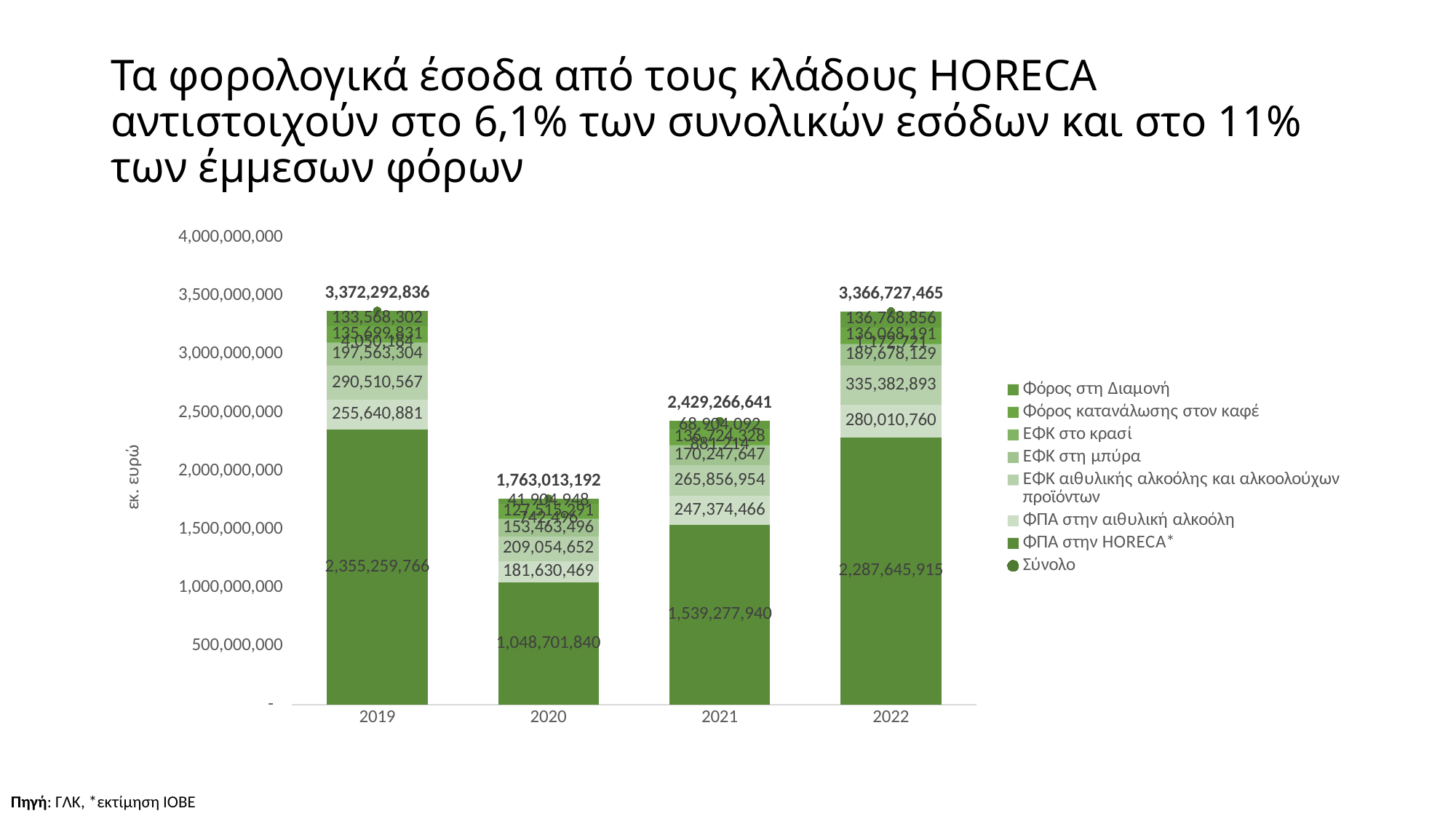
What is the total (Σύνολο) value shown for 2019? 3,372,292,836 Which year has the lowest total value? 2020 Is the total for 2020 greater or less than 2,000,000,000? less What is the total (Σύνολο) value shown for 2020? 1,763,013,192 How many years are shown on the x axis? 4 What is the value of ΦΠΑ στην HORECA* for 2022? 2,287,645,915 What is the difference between the total for 2022 and the total for 2021? 937,460,824 Which year has the highest total value? 2019 Which is larger: the total for 2019 or the total for 2022? 2019 How many entries does the legend list? 8 What kind of chart is shown on the slide? Stacked bar chart What is the value of ΦΠΑ στην HORECA* for 2021? 1,539,277,940